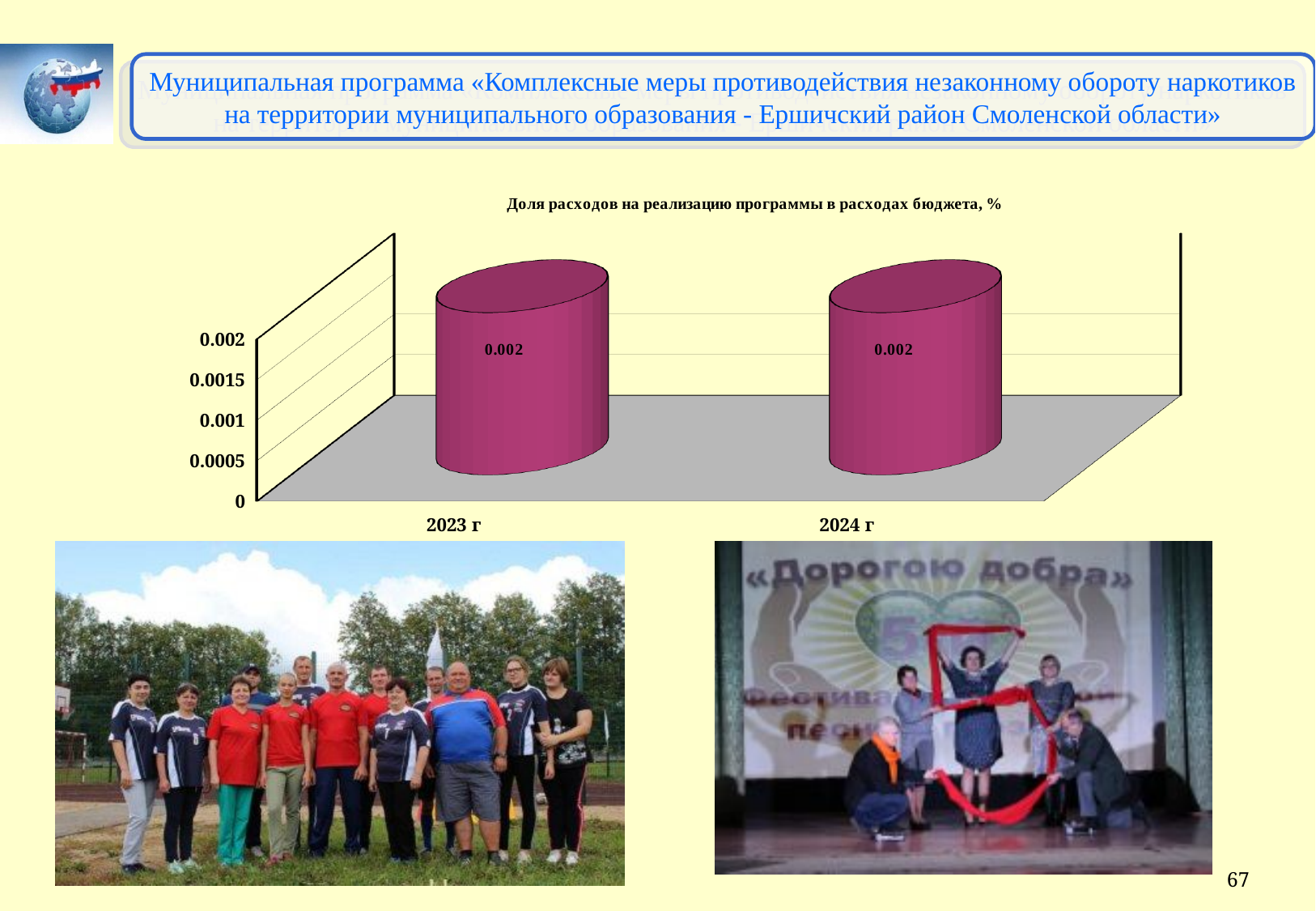
What is the difference between the values for 2023 г and 2024 г? 0 How many categories (years) are shown on the x axis of the chart? 2 Is the value for 2024 г greater or less than 0.001? greater Do the values rise, fall or stay the same from 2023 г to 2024 г? stay the same What is the value for 2023 г in the chart? 0.002 Is the value for 2023 г greater or less than 0.0015? greater What kind of chart is shown on the slide? bar chart What is the title of the chart? Доля расходов на реализацию программы в расходах бюджета, % What is the value for 2024 г in the chart? 0.002 What is the highest tick value shown on the vertical axis of the chart? 0.002